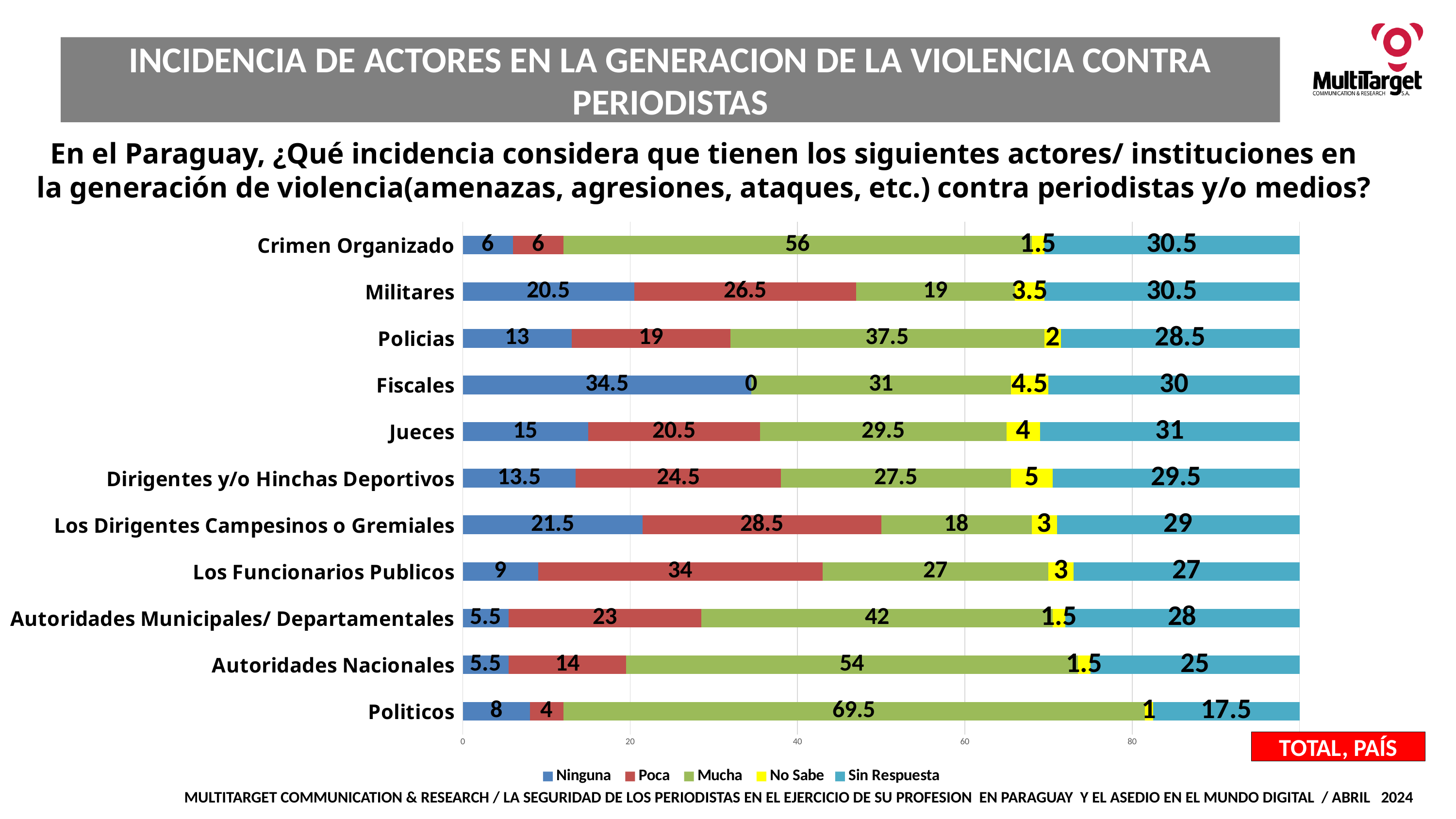
What kind of chart is shown on the slide? Stacked bar chart Which actor has the lowest 'Poca' value? Fiscales What is the total of the stacked bar for Jueces? 100 What is the difference between the 'Mucha' values for Crimen Organizado and Militares? 37 What is the 'Mucha' value for Politicos? 69.5 Which actor has the highest 'Mucha' value? Politicos What is the 'Ninguna' value for Fiscales? 34.5 Which series is shown in yellow in the legend? No Sabe What is the 'Sin Respuesta' value for Autoridades Nacionales? 25 How many actors/institutions are shown on the chart? 11 Which is larger: the 'Poca' value for Los Funcionarios Publicos or for Militares? Los Funcionarios Publicos How many series does the legend list? 5